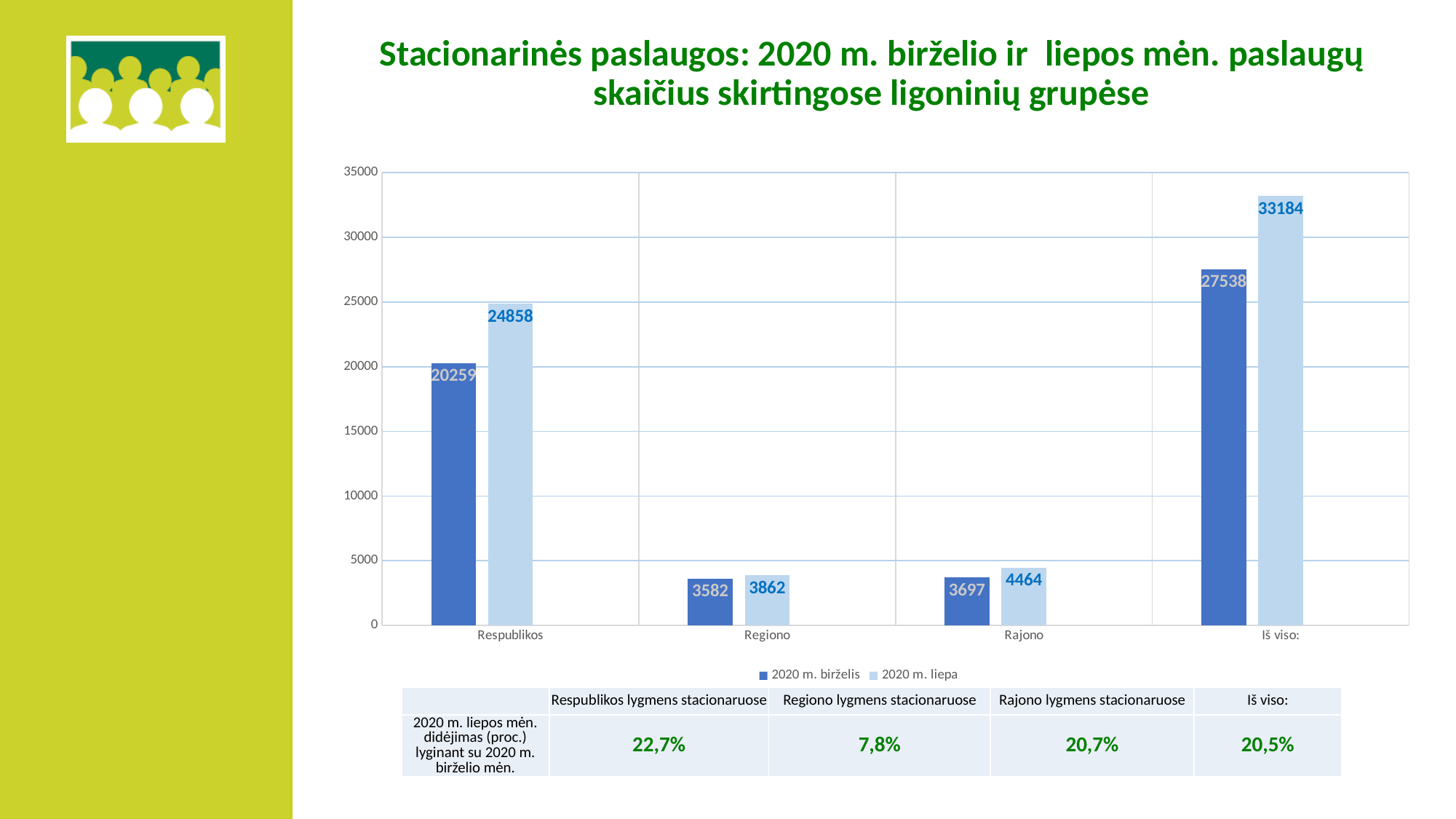
What kind of chart is shown on the slide? bar chart What is the value for Iš viso: in the 2020 m. liepa series? 33184 What is the value for Rajono in the 2020 m. liepa series? 4464 What is the difference between the 2020 m. liepa and 2020 m. birželis values for Respublikos? 4599 How many categories are shown on the x axis? 4 What is the difference between the 2020 m. liepa and 2020 m. birželis values for Regiono? 280 What is the value for Respublikos in the 2020 m. birželis series? 20259 Which category has the highest value in the 2020 m. liepa series? Iš viso: How many series does the legend list? 2 Which is larger for Rajono: the 2020 m. birželis value or the 2020 m. liepa value? 2020 m. liepa Is the 2020 m. birželis value for Iš viso: greater or less than 25000? greater Which category has the lowest value in the 2020 m. birželis series? Regiono